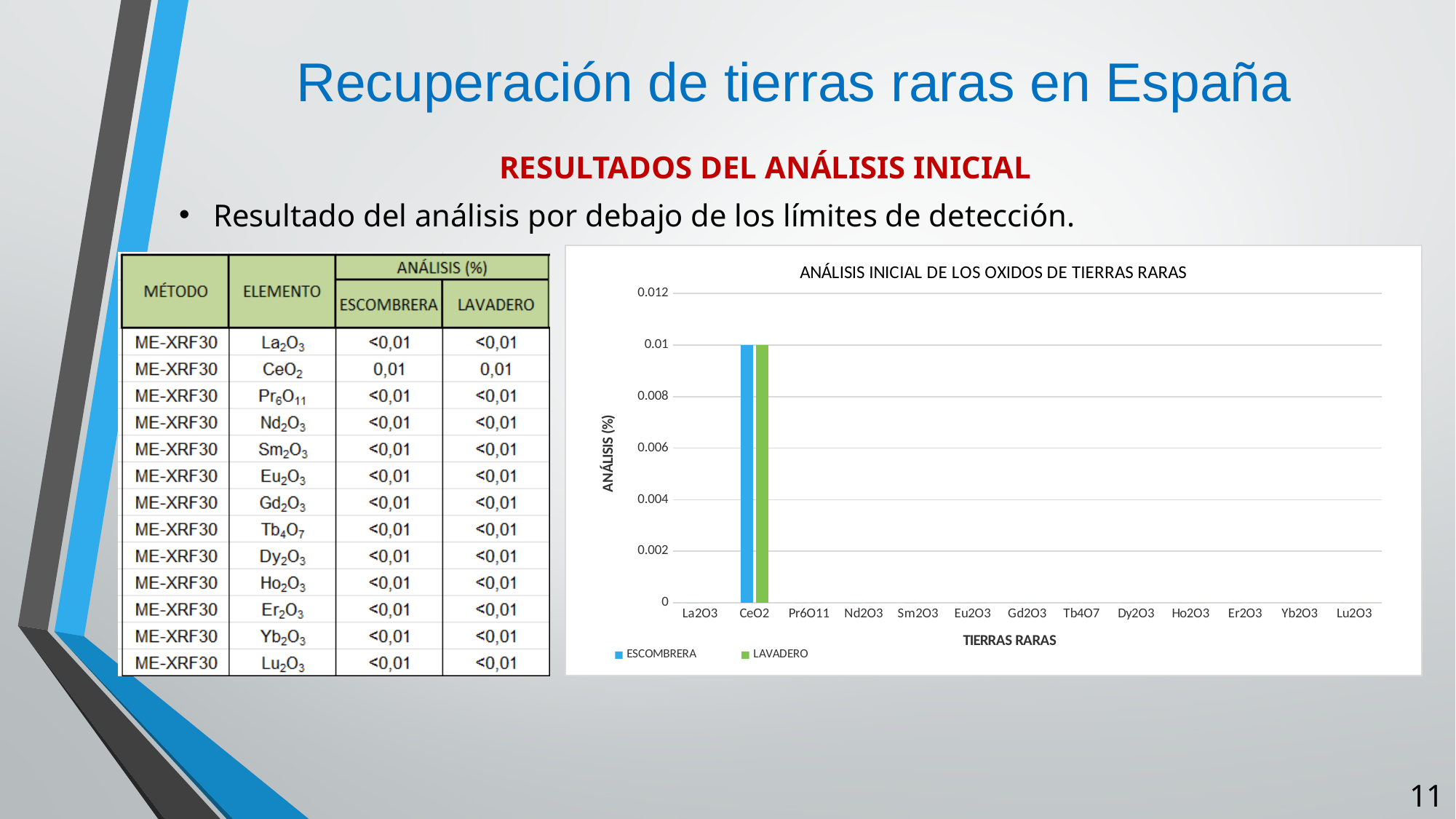
What is the ESCOMBRERA value for CeO2 in the chart? 0.01 Is the LAVADERO value for CeO2 greater or less than 0.012? less Which category has the highest value in the chart? CeO2 Which series is shown in green in the chart? LAVADERO What is the LAVADERO value for CeO2 in the chart? 0.01 How many series does the chart legend list? 2 What is the title of the chart? ANÁLISIS INICIAL DE LOS OXIDOS DE TIERRAS RARAS What kind of chart is shown on the slide? bar chart How many categories are shown on the x axis of the chart? 13 Which category is the only one with visible bars in the chart? CeO2 Is the ESCOMBRERA value for CeO2 greater or less than 0.008? greater What is the label of the y axis of the chart? ANÁLISIS (%)